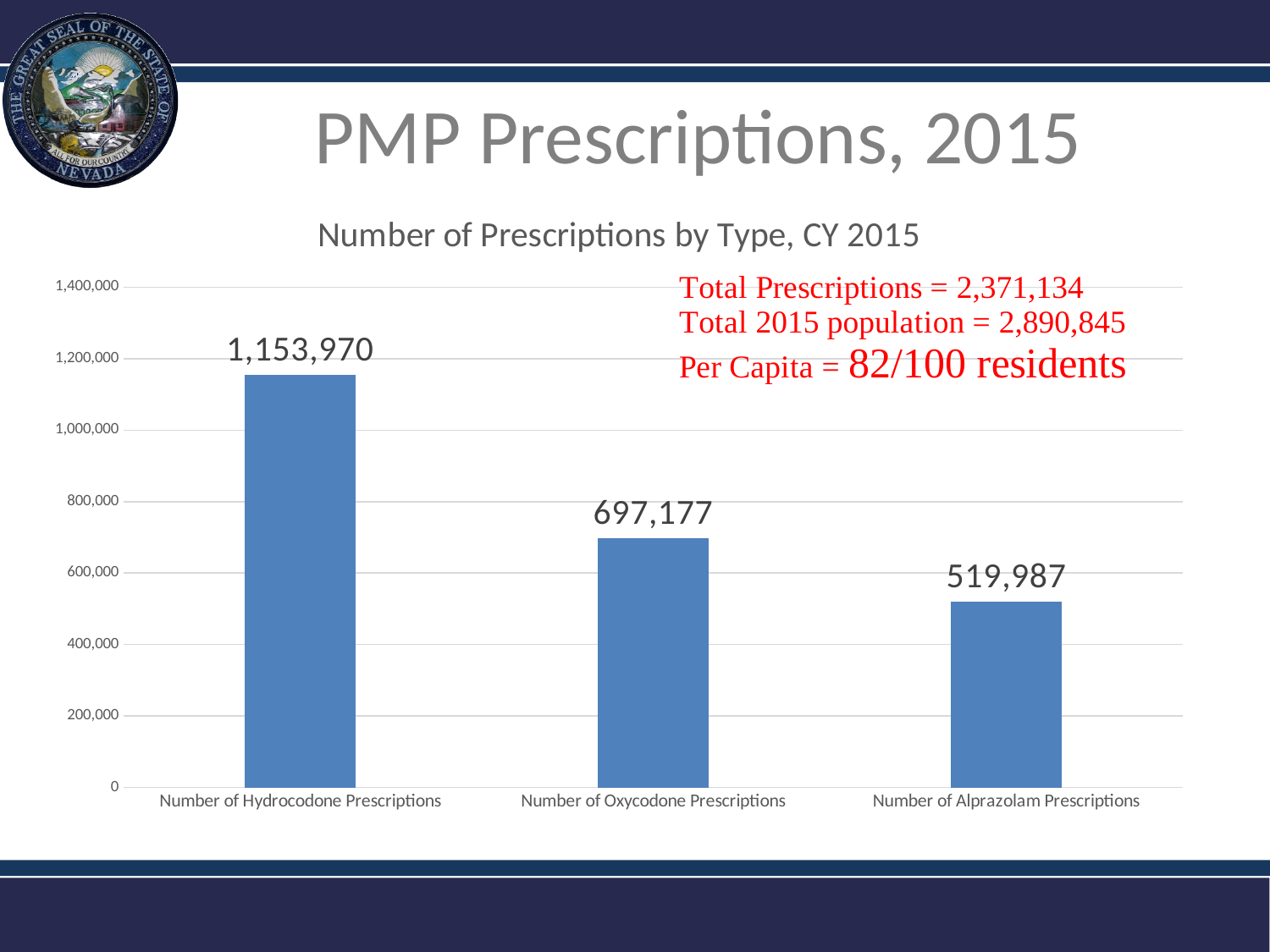
How many prescription types are shown in the chart? 3 Which is larger, the number of Oxycodone prescriptions or the number of Alprazolam prescriptions? Number of Oxycodone Prescriptions What kind of chart is shown on the slide? Bar chart Is the number of Hydrocodone prescriptions greater or less than 1,000,000? greater What is the number of Alprazolam prescriptions shown in the chart? 519,987 What is the title of the chart? Number of Prescriptions by Type, CY 2015 What is the number of Oxycodone prescriptions shown in the chart? 697,177 Which prescription type has the highest number of prescriptions? Number of Hydrocodone Prescriptions What is the difference between the number of Hydrocodone prescriptions and the number of Oxycodone prescriptions? 456,793 What is the number of Hydrocodone prescriptions shown in the chart? 1,153,970 Which prescription type has the lowest number of prescriptions? Number of Alprazolam Prescriptions What is the difference between the number of Oxycodone prescriptions and the number of Alprazolam prescriptions? 177,190